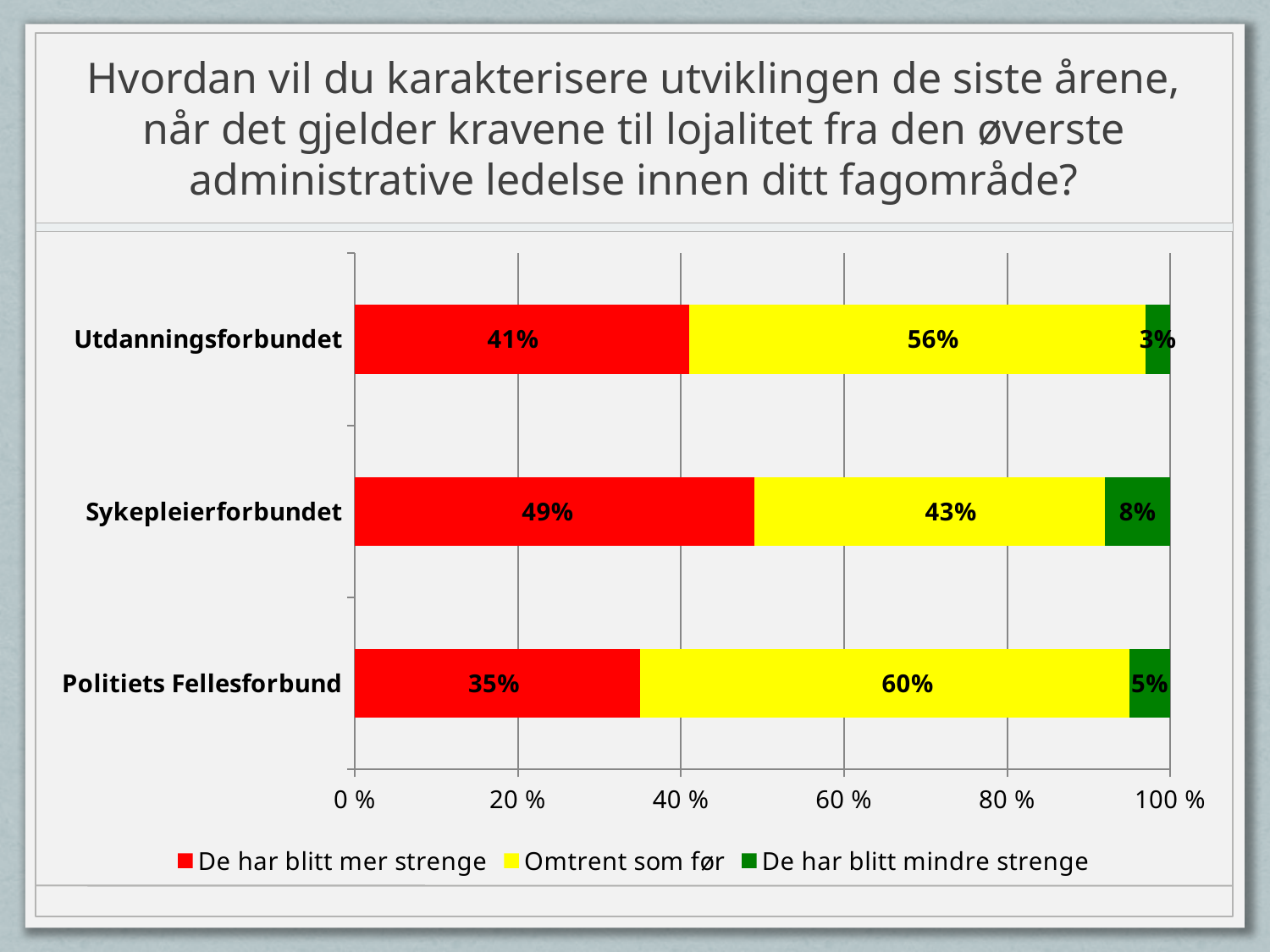
How many categories (unions) are shown on the chart? 3 What percentage of Utdanningsforbundet respondents answered "De har blitt mer strenge"? 41% What percentage of Sykepleierforbundet respondents answered "Omtrent som før"? 43% Which colour represents "Omtrent som før" in the chart? Yellow Which category has the highest share for "De har blitt mer strenge"? Sykepleierforbundet What is the total of the stacked bar for Sykepleierforbundet? 100% What kind of chart is shown on the slide? Stacked bar chart What is the difference between the "Omtrent som før" shares for Politiets Fellesforbund and Utdanningsforbundet? 4% Which category has the lowest share for "Omtrent som før"? Sykepleierforbundet Which is larger: the "De har blitt mindre strenge" share for Sykepleierforbundet or for Utdanningsforbundet? Sykepleierforbundet What percentage of Politiets Fellesforbund respondents answered "De har blitt mindre strenge"? 5% How many series does the legend list? 3